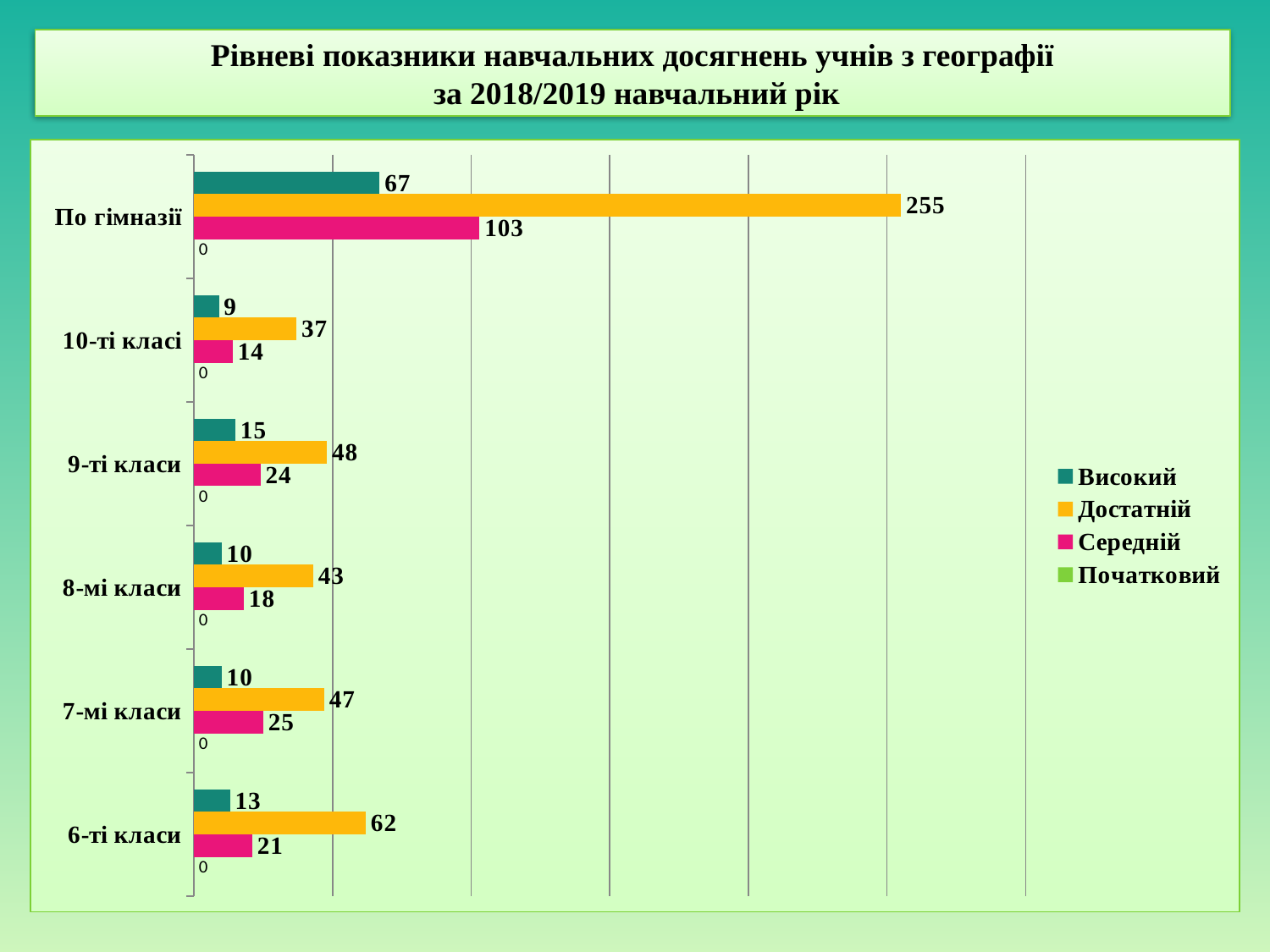
Which category has the lowest Високий value? 10-ті класі Which is larger: the Середній value for 8-мі класи or the Середній value for 6-ті класи? 6-ті класи What is the value for Високий for 10-ті класі? 9 Which colour represents the Достатній series in the legend? Orange What is the difference between the Достатній and Середній values for 9-ті класи? 24 How many series does the legend list? 4 What is the value for Середній for 7-мі класи? 25 How many categories are shown on the vertical axis? 6 What kind of chart is shown on the slide? Bar chart What is the value for Початковий for 6-ті класи? 0 Among the class groups (excluding По гімназії), which category has the highest Достатній value? 6-ті класи What is the value for Достатній for По гімназії? 255